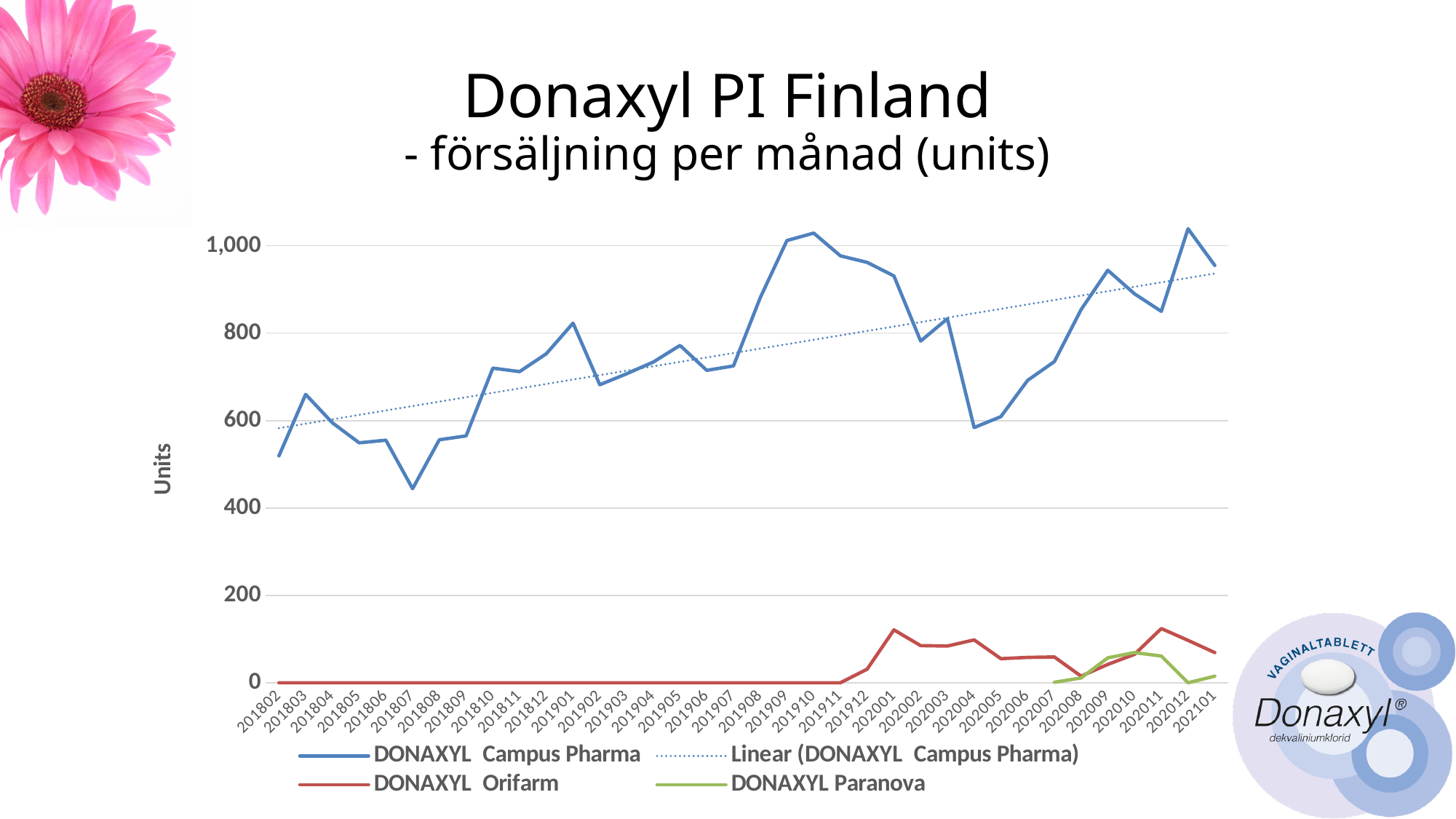
Does the DONAXYL Campus Pharma trend line rise or fall from left to right? rise How many months are plotted along the x axis? 36 Which series is drawn as a dotted line? Linear (DONAXYL Campus Pharma) Is the value for DONAXYL Orifarm in 202001 greater or less than 200? less Is the value for DONAXYL Campus Pharma in 201910 greater or less than 1,000? greater Is the value for DONAXYL Campus Pharma in 201802 greater or less than 600? less What is the label on the vertical axis? Units How many series does the legend list? 4 In which month is the DONAXYL Campus Pharma line at its lowest? 201807 What kind of chart is shown on the slide? line chart In 202001, which series has the larger value, DONAXYL Campus Pharma or DONAXYL Orifarm? DONAXYL Campus Pharma